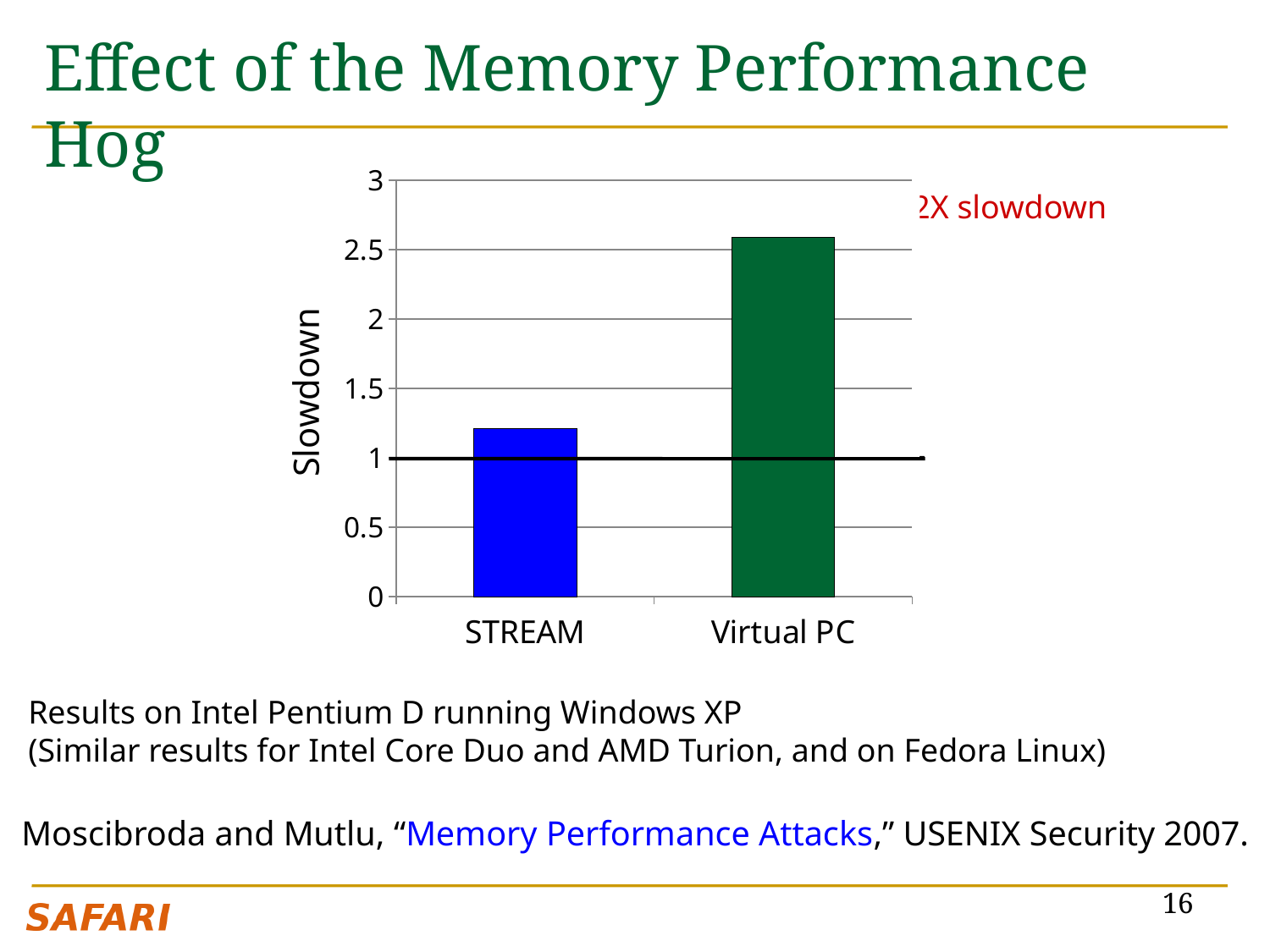
Is the slowdown for STREAM greater or less than 1.5? less What kind of chart is shown on the slide? bar chart Is the slowdown for Virtual PC greater or less than 2.5? greater How many categories are plotted on the x axis? 2 Which category has the highest slowdown? Virtual PC Is the slowdown for Virtual PC greater or less than 3? less Which category has the lowest slowdown? STREAM Which has a larger slowdown, STREAM or Virtual PC? Virtual PC What colour is the bar for Virtual PC? green What is the label of the y axis? Slowdown